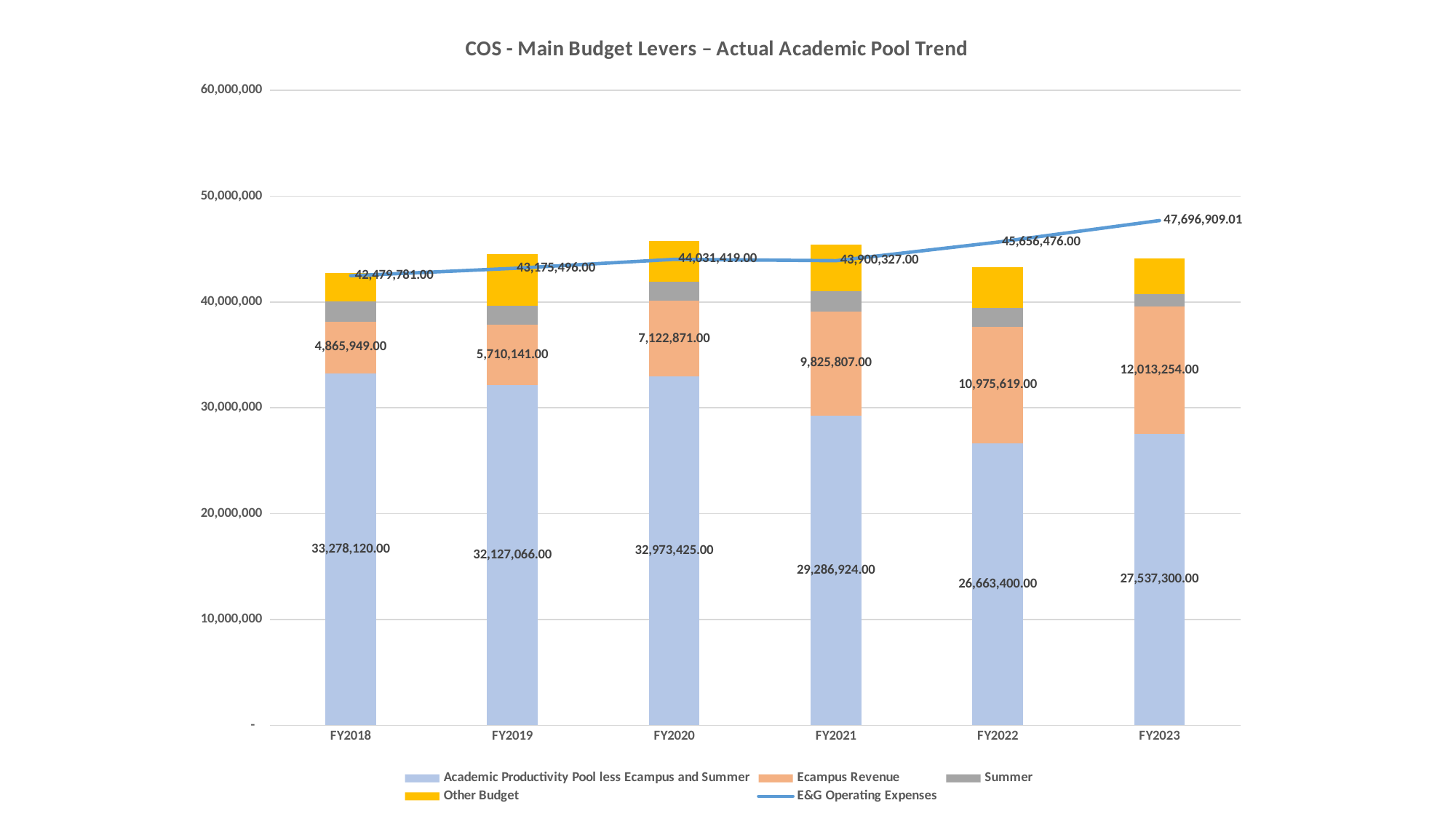
In which fiscal year is Academic Productivity Pool less Ecampus and Summer lowest? FY2022 Does Ecampus Revenue rise or fall from FY2018 to FY2023? rise In which fiscal year is Ecampus Revenue highest? FY2023 What is the value of Academic Productivity Pool less Ecampus and Summer for FY2018? 33,278,120.00 Which is larger, Academic Productivity Pool less Ecampus and Summer in FY2019 or in FY2020? FY2020 Is the value of Academic Productivity Pool less Ecampus and Summer for FY2021 greater or less than 30,000,000? less What is the difference between E&G Operating Expenses in FY2023 and FY2022? 2,040,433.01 What kind of chart is this? Stacked bar chart with a line How many series does the legend list? 5 What is the E&G Operating Expenses value for FY2020? 44,031,419.00 How many fiscal years are shown on the x axis? 6 What is the Ecampus Revenue value for FY2023? 12,013,254.00